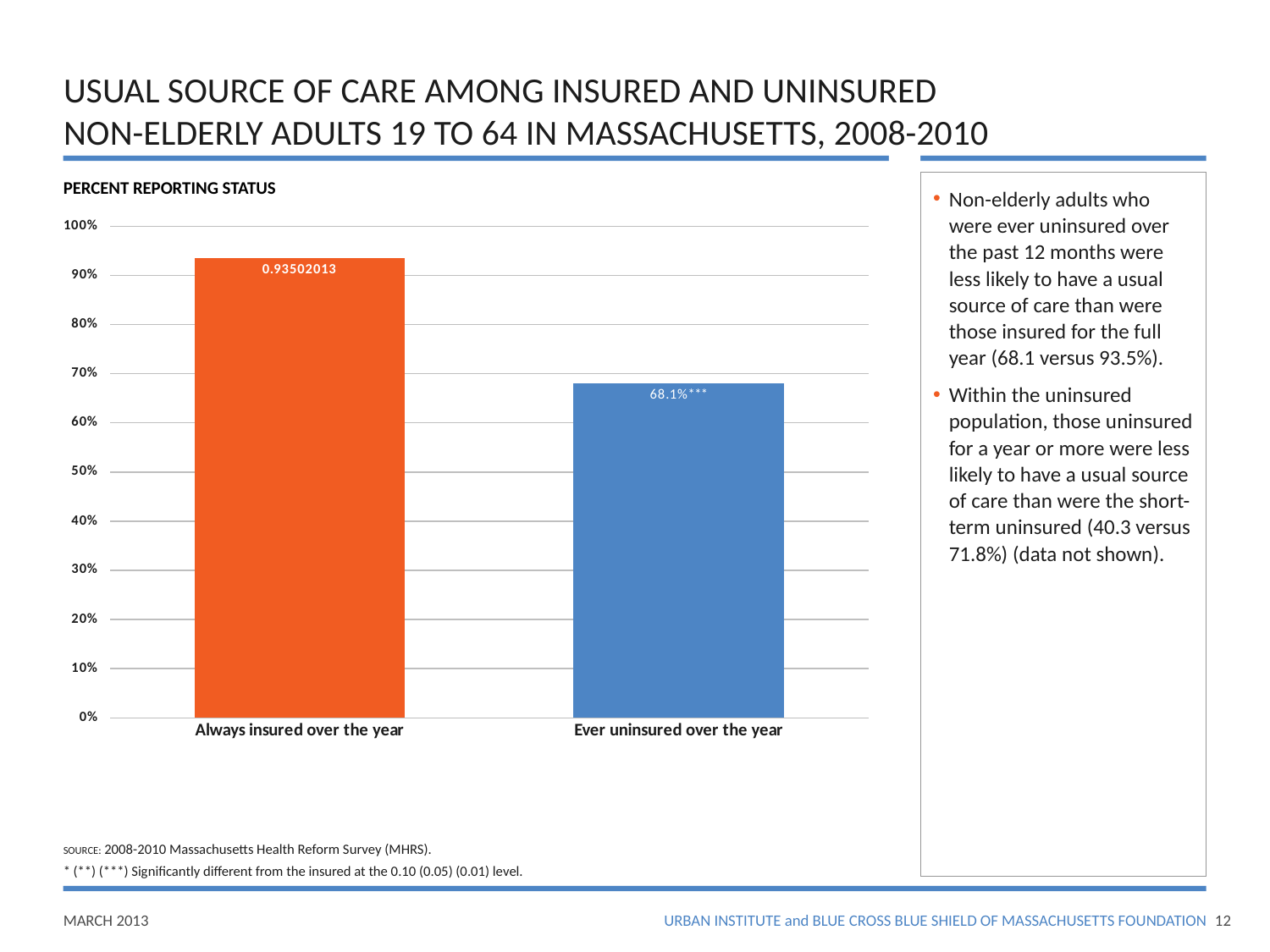
What kind of chart is shown on the slide? Bar chart Which bar is taller: "Always insured over the year" or "Ever uninsured over the year"? Always insured over the year Which category has the highest bar? Always insured over the year Which category has the lowest bar? Ever uninsured over the year What colour is the bar for "Ever uninsured over the year"? Blue Is the value for "Ever uninsured over the year" greater or less than 70%? less What data label is shown on the bar for "Always insured over the year"? 0.93502013 What is the title printed above the chart? PERCENT REPORTING STATUS How many categories are plotted on the chart? 2 What data label is shown on the bar for "Ever uninsured over the year"? 68.1%*** Is the value for "Always insured over the year" greater or less than 90%? greater Is the value for "Ever uninsured over the year" greater or less than 60%? greater